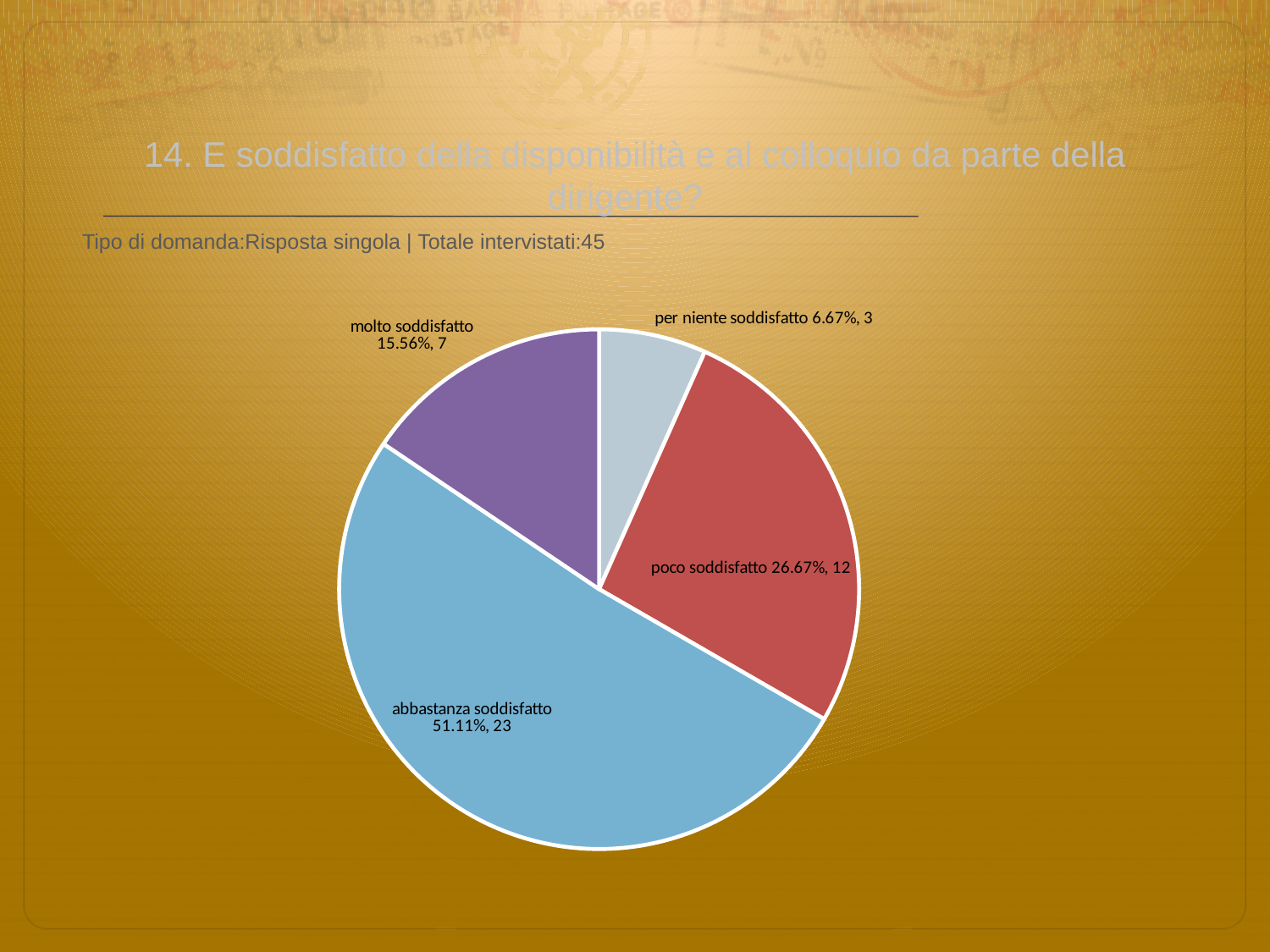
What percentage share does the 'per niente soddisfatto' slice have? 6.67% What percentage share does the 'abbastanza soddisfatto' slice have? 51.11% Which category has the largest slice of the pie? abbastanza soddisfatto What is the difference in respondent count between 'abbastanza soddisfatto' and 'poco soddisfatto'? 11 How many respondents answered 'molto soddisfatto'? 7 Which category has the smallest slice of the pie? per niente soddisfatto How many respondents answered 'poco soddisfatto'? 12 What colour is the 'abbastanza soddisfatto' slice? light blue How many slices does the pie chart have? 4 What is the total number of respondents shown on the slide? 45 What kind of chart is shown on the slide? pie chart Which has more respondents, 'molto soddisfatto' or 'poco soddisfatto'? poco soddisfatto